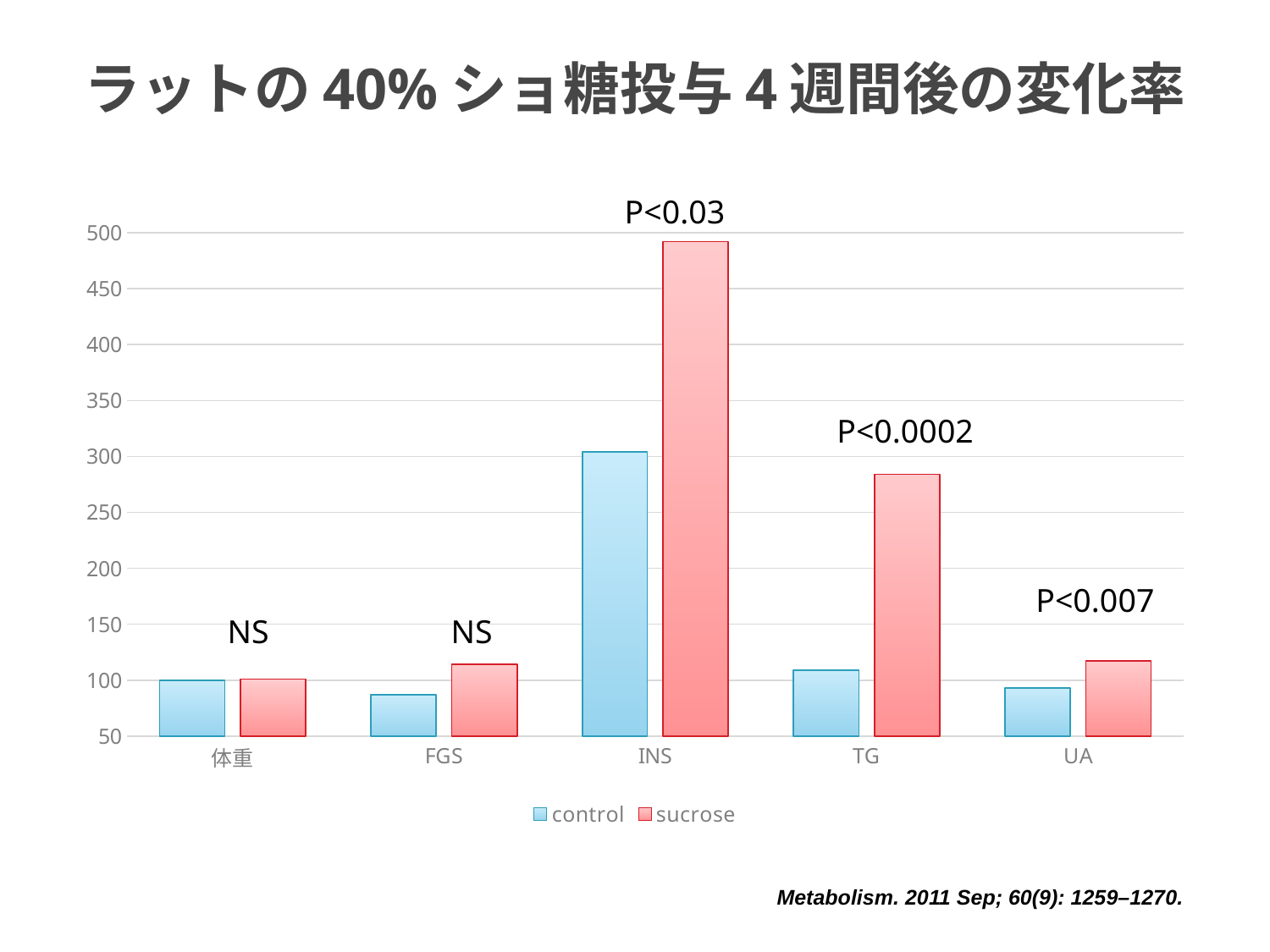
What kind of chart is shown on the slide? bar chart Is the sucrose value for TG greater or less than 250? greater How many series does the legend list? 2 How many categories are shown on the x axis? 5 Is the sucrose value for INS greater or less than 450? greater What P-value annotation is shown above the INS bars? P<0.03 Which category has the tallest control bar? INS Which category has the tallest sucrose bar? INS Is the control value for FGS greater or less than 100? less What are the two legend entries? control, sucrose For TG, which is larger, the control bar or the sucrose bar? sucrose